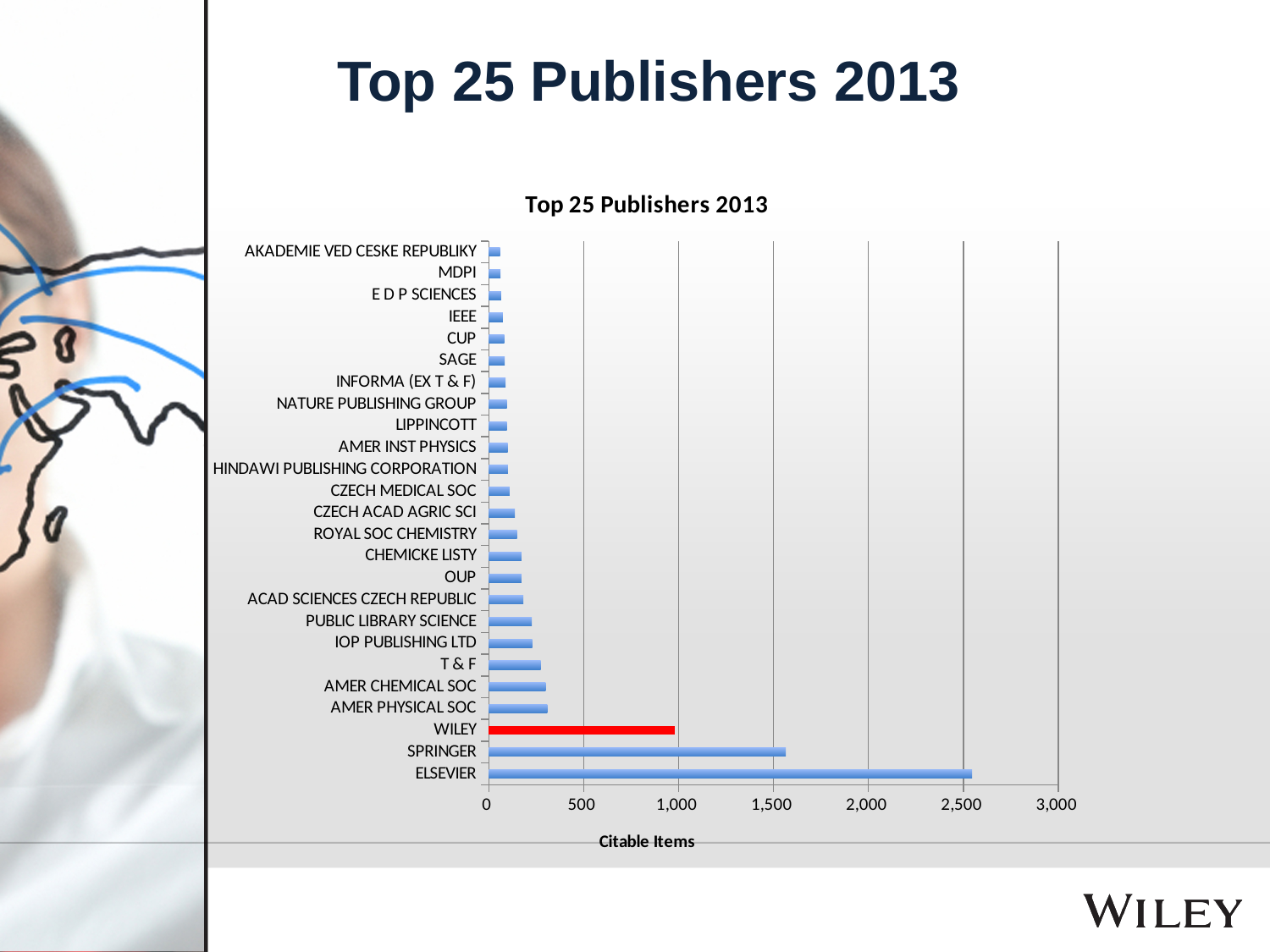
Which publisher has the highest number of citable items? ELSEVIER Which publisher's bar is coloured red? WILEY Is the value for WILEY greater or less than 500? greater What kind of chart is shown on the slide? bar chart Is the value for AMER PHYSICAL SOC greater or less than 500? less Which has more citable items, SPRINGER or WILEY? SPRINGER What is the title of the x axis? Citable Items How many publishers are listed on the chart? 25 Which publisher has the lowest number of citable items? AKADEMIE VED CESKE REPUBLIKY Which has more citable items, ELSEVIER or SPRINGER? ELSEVIER Is the value for SPRINGER greater or less than 1,000? greater